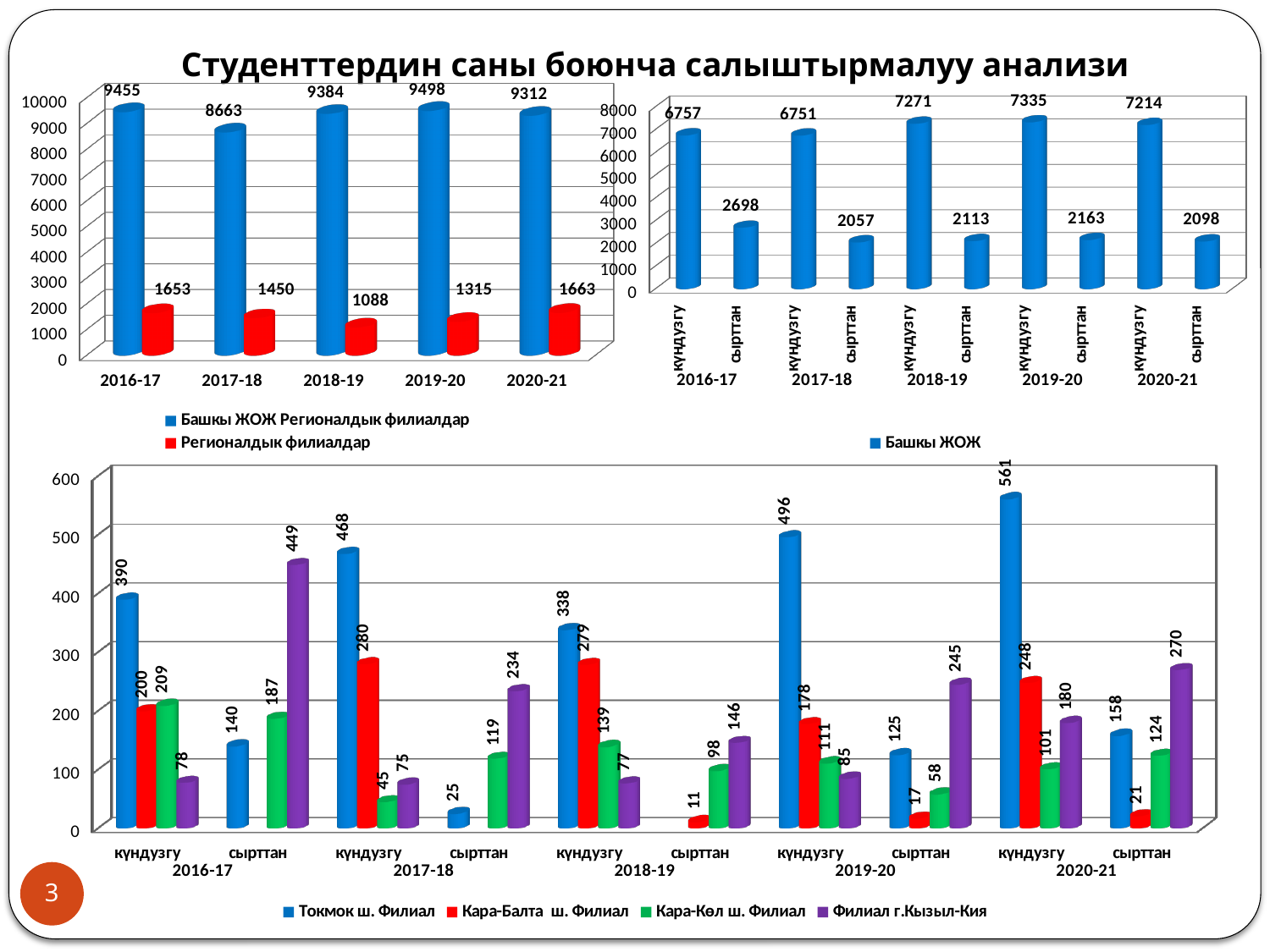
What type of chart is the bottom chart? bar chart In the top-right chart (Башкы ЖОЖ), what is the value for сырттан in 2016-17? 2698 In the bottom chart, what is the difference between Кара-Көл ш. Филиал сырттан in 2020-21 and Кара-Балта ш. Филиал сырттан in 2020-21? 103 In the top-left chart, what is the value of the blue series (Башкы ЖОЖ Регионалдык филиалдар) for 2019-20? 9498 In the bottom chart, what is the value for Филиал г.Кызыл-Кия сырттан in 2016-17? 449 In the top-left chart, what is the difference between the blue and red values for 2017-18? 7213 In the bottom chart, what is the value for Токмок ш. Филиал күндүзгү in 2020-21? 561 In the bottom chart, which is larger for күндүзгү 2017-18: Токмок ш. Филиал or Кара-Балта ш. Филиал? Токмок ш. Филиал How many series does the legend of the bottom chart list? 4 In the top-right chart (Башкы ЖОЖ), which year has the highest күндүзгү value? 2019-20 In the top-left chart, which year has the lowest value for Регионалдык филиалдар? 2018-19 In the top-right chart (Башкы ЖОЖ), is the сырттан value for 2018-19 greater or less than 3000? less